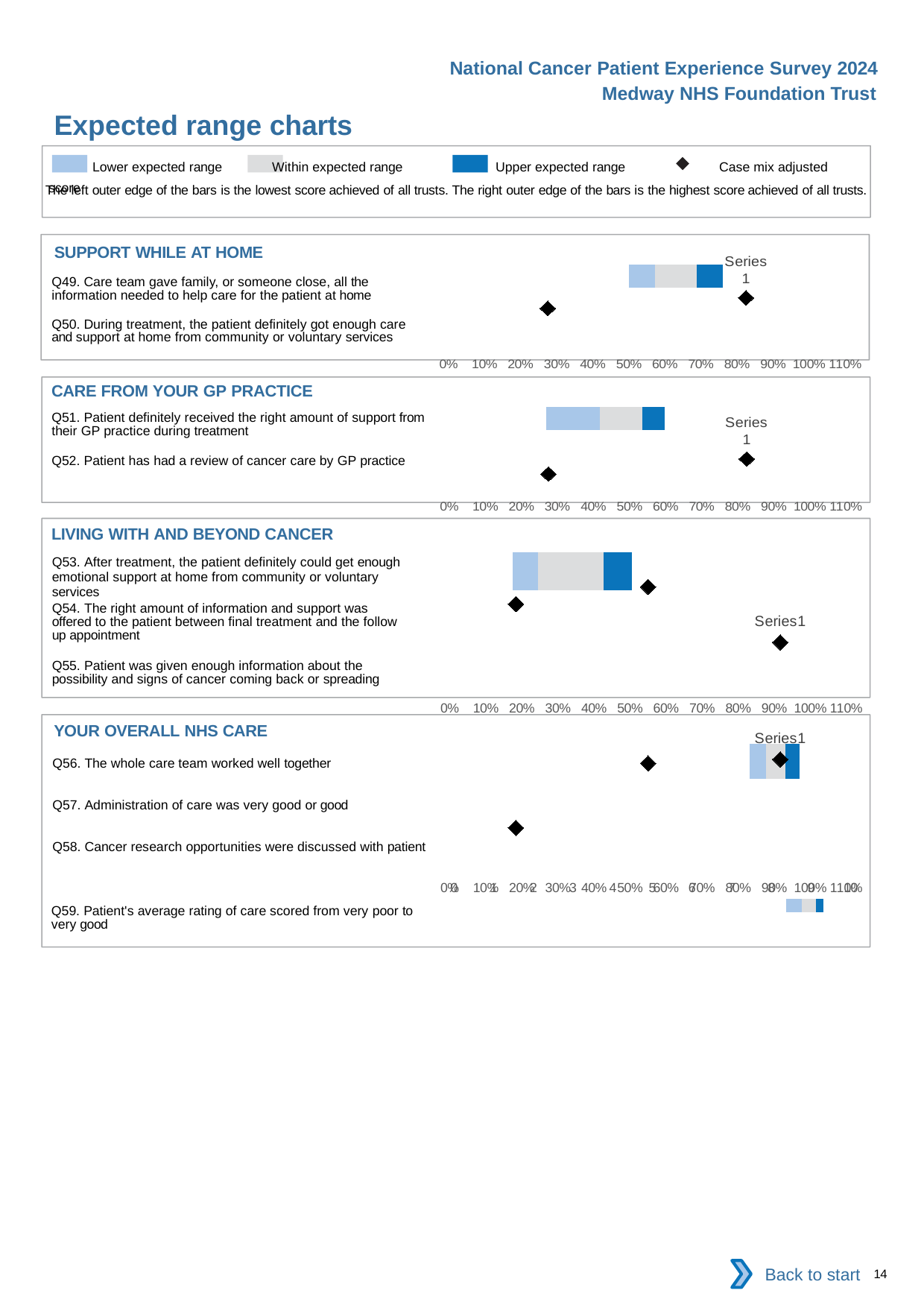
According to the legend, what does the black diamond marker represent? Case mix adjusted score How many questions are listed in the 'YOUR OVERALL NHS CARE' chart? 4 According to the legend, which expected range is shown in dark blue? Upper expected range How many questions are listed in the 'CARE FROM YOUR GP PRACTICE' chart? 2 In the 'SUPPORT WHILE AT HOME' chart, is the rightmost diamond marker greater or less than 70%? greater In the 'CARE FROM YOUR GP PRACTICE' chart, is the leftmost diamond marker greater or less than 40%? less What is the highest tick label shown on the x axis of the 'SUPPORT WHILE AT HOME' chart? 110% What kind of chart is used in the 'SUPPORT WHILE AT HOME' section? bar chart In the 'SUPPORT WHILE AT HOME' chart, is the leftmost diamond marker greater or less than 40%? less How many entries does the legend at the top of the slide list? 4 How many questions are listed in the 'LIVING WITH AND BEYOND CANCER' chart? 3